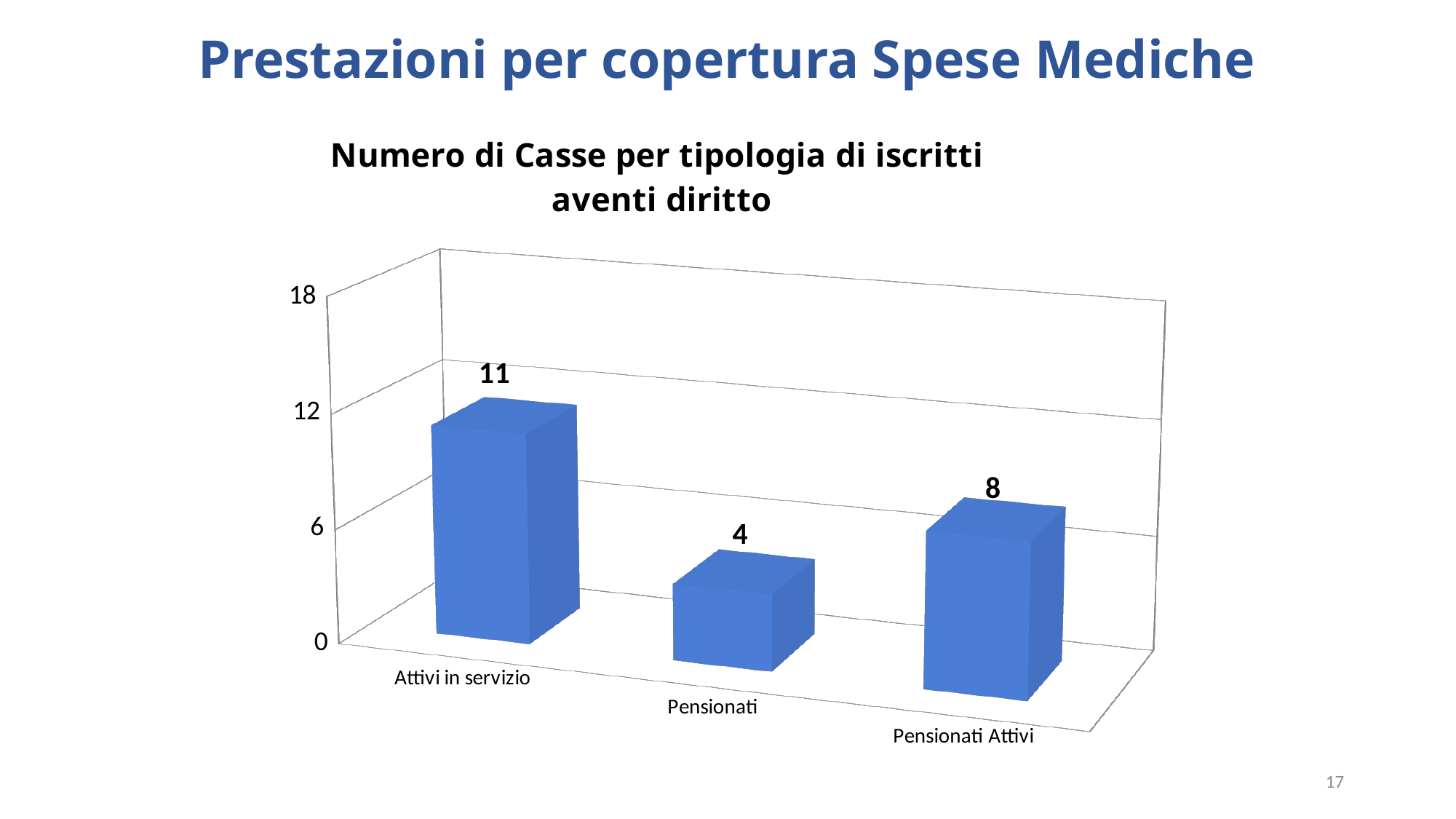
What is the difference between the values for Pensionati Attivi and Pensionati? 4 What is the value for Pensionati? 4 What is the title of the chart? Numero di Casse per tipologia di iscritti aventi diritto Is the value for Pensionati Attivi greater or less than 12? less How many categories are shown in the chart? 3 What is the value for Attivi in servizio? 11 Which is larger, the value for Pensionati Attivi or the value for Pensionati? Pensionati Attivi Which category has the lowest value? Pensionati Which category has the highest value? Attivi in servizio What is the difference between the values for Attivi in servizio and Pensionati? 7 What kind of chart is shown on the slide? bar chart What is the value for Pensionati Attivi? 8